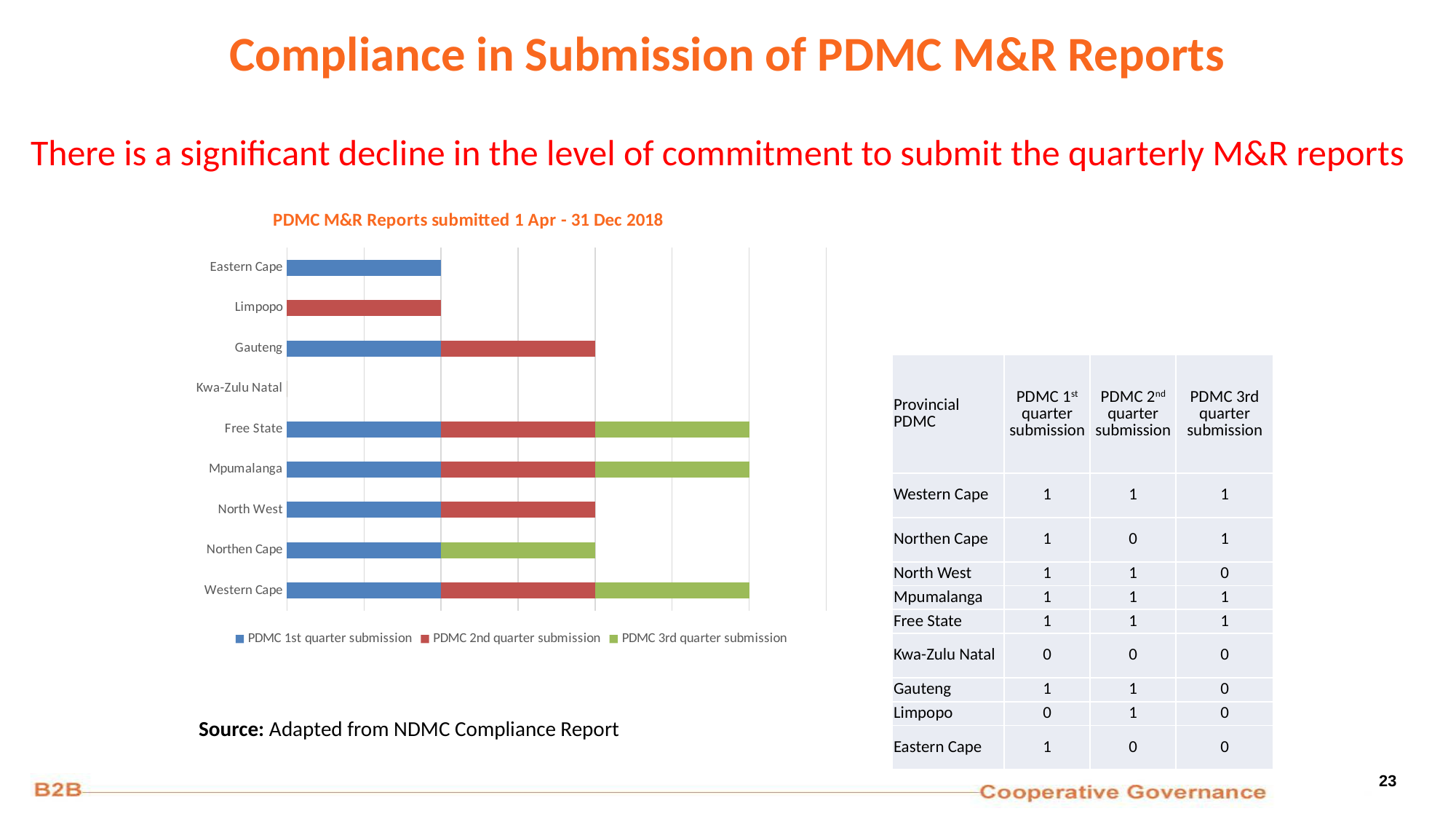
What kind of chart is shown on the slide? bar chart Which has the larger stacked bar total, Gauteng or Mpumalanga? Mpumalanga What is the title of the chart? PDMC M&R Reports submitted 1 Apr - 31 Dec 2018 Which series is shown in green in the chart? PDMC 3rd quarter submission Which province has no bar at all in the chart? Kwa-Zulu Natal How many series does the chart's legend list? 3 What is the total of the stacked bar for Free State? 3 What is the value for Northen Cape in the PDMC 2nd quarter submission series? 0 What is the value for Limpopo in the PDMC 1st quarter submission series? 0 What is the total of the stacked bar for Eastern Cape? 1 How many provinces are listed on the chart's vertical axis? 9 What is the total of the stacked bar for Western Cape? 3